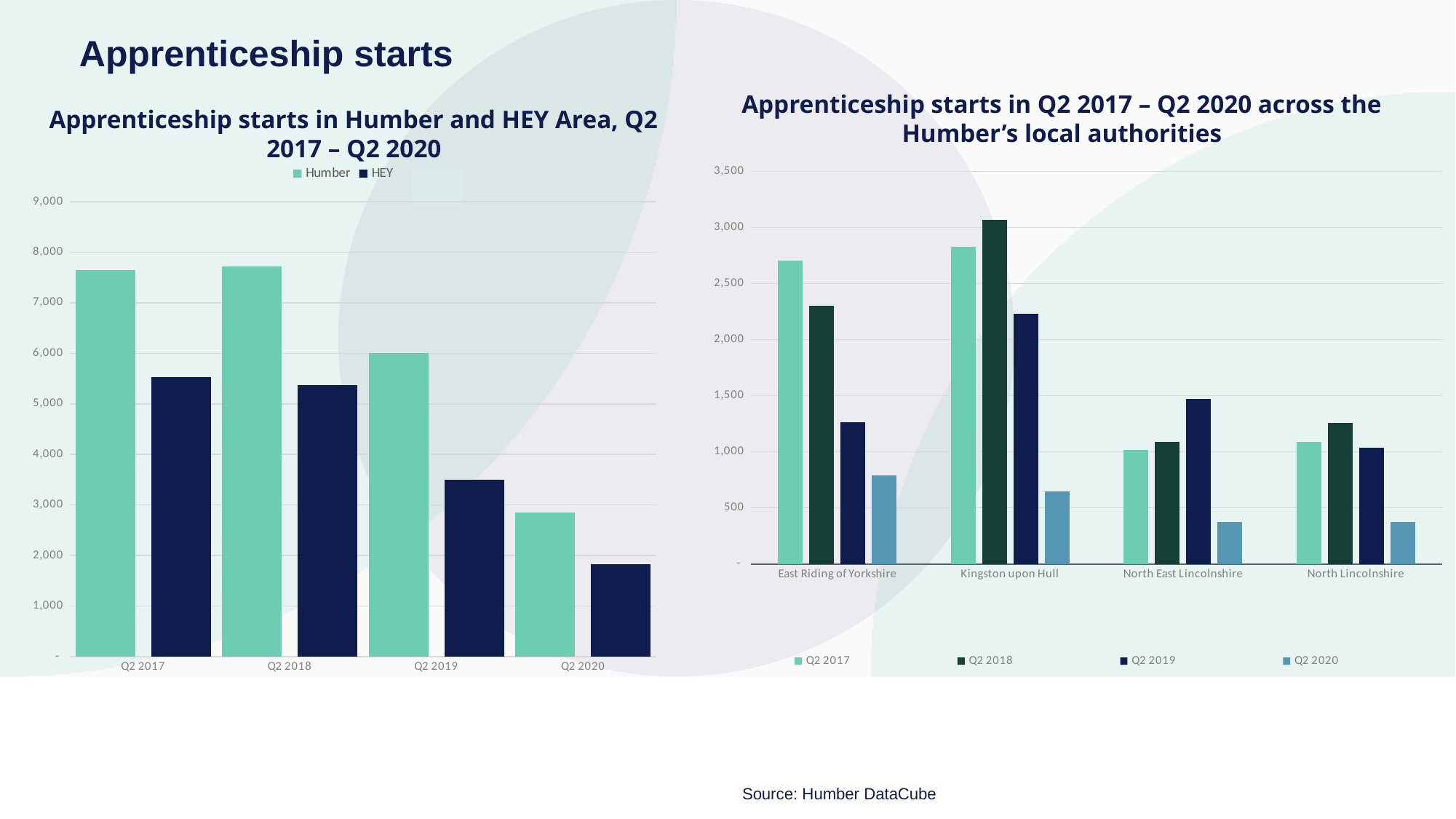
In the left chart, in which quarter is the Humber value lowest? Q2 2020 In the right chart, 'Apprenticeship starts in Q2 2017 – Q2 2020 across the Humber's local authorities', how many series does the legend list? 4 In the left chart, which is larger in Q2 2019, Humber or HEY? Humber In the left chart, how many series does the legend list? 2 In the right chart, which local authority has the highest Q2 2018 value? Kingston upon Hull In the right chart, is the Q2 2020 value for North East Lincolnshire greater or less than 500? less In the left chart, how many quarters are shown on the x axis? 4 In the right chart, which is larger for East Riding of Yorkshire, the Q2 2017 value or the Q2 2019 value? Q2 2017 In the left chart, do the HEY values rise or fall from Q2 2017 to Q2 2020? fall In the left chart, is the HEY value for Q2 2020 greater or less than 2,000? less In the left chart, is the Humber value for Q2 2019 greater or less than 5,000? greater What kind of chart is the left chart, 'Apprenticeship starts in Humber and HEY Area, Q2 2017 – Q2 2020'? bar chart